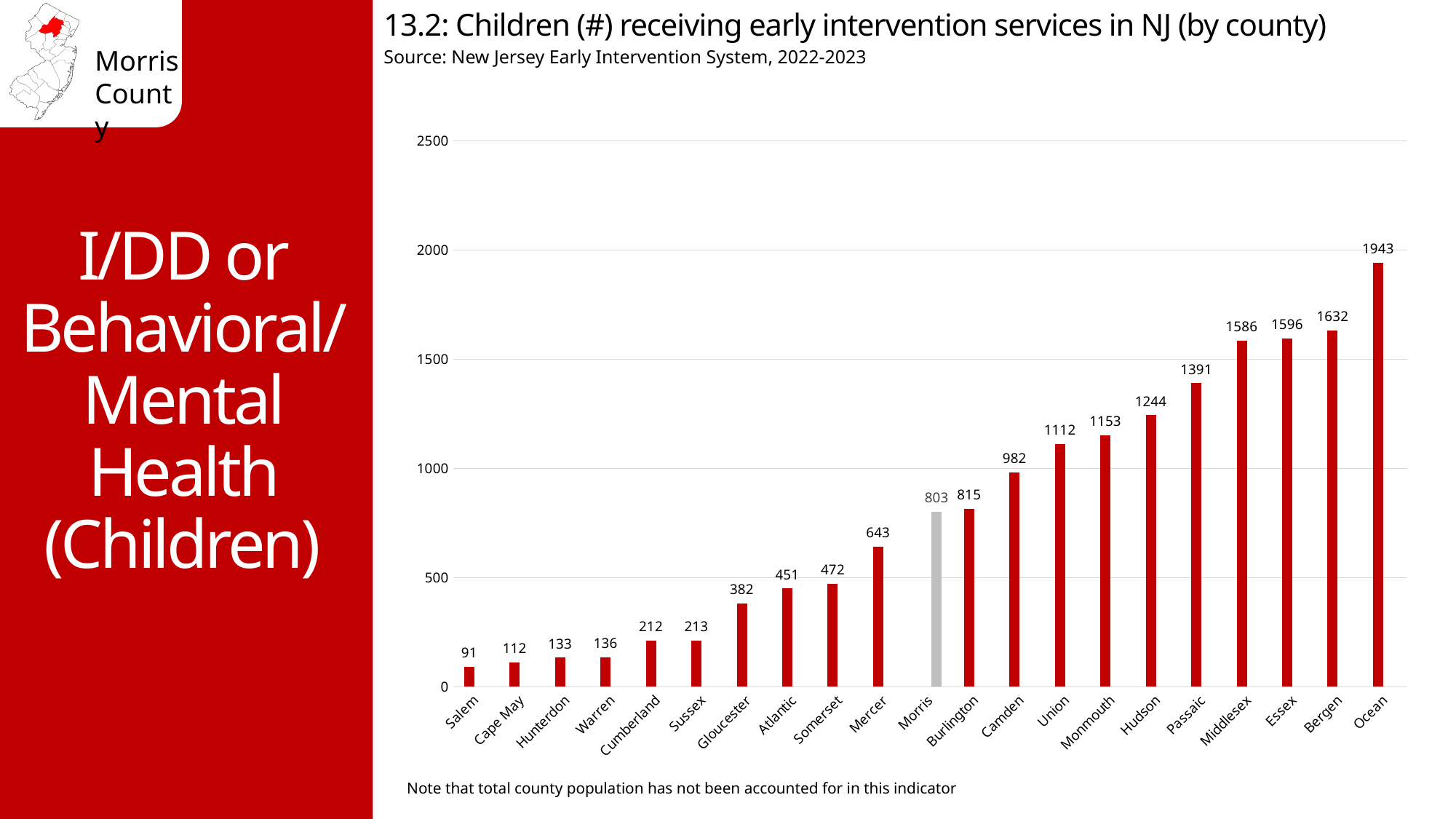
Which county has the highest number of children receiving early intervention services? Ocean Which county has the lowest number of children receiving early intervention services? Salem Which county's bar is shown in gray rather than red? Morris What is the value shown for Burlington County? 815 What type of chart is shown on the slide? Bar chart What is the value shown for Ocean County? 1943 How many children are receiving early intervention services in Morris County? 803 What is the difference between the values for Ocean and Morris? 1140 How many counties are shown on the chart? 21 Is the value for Mercer greater or less than 500? greater Do the values rise or fall moving from left to right along the x axis? Rise Which county has a larger value, Hudson or Camden? Hudson